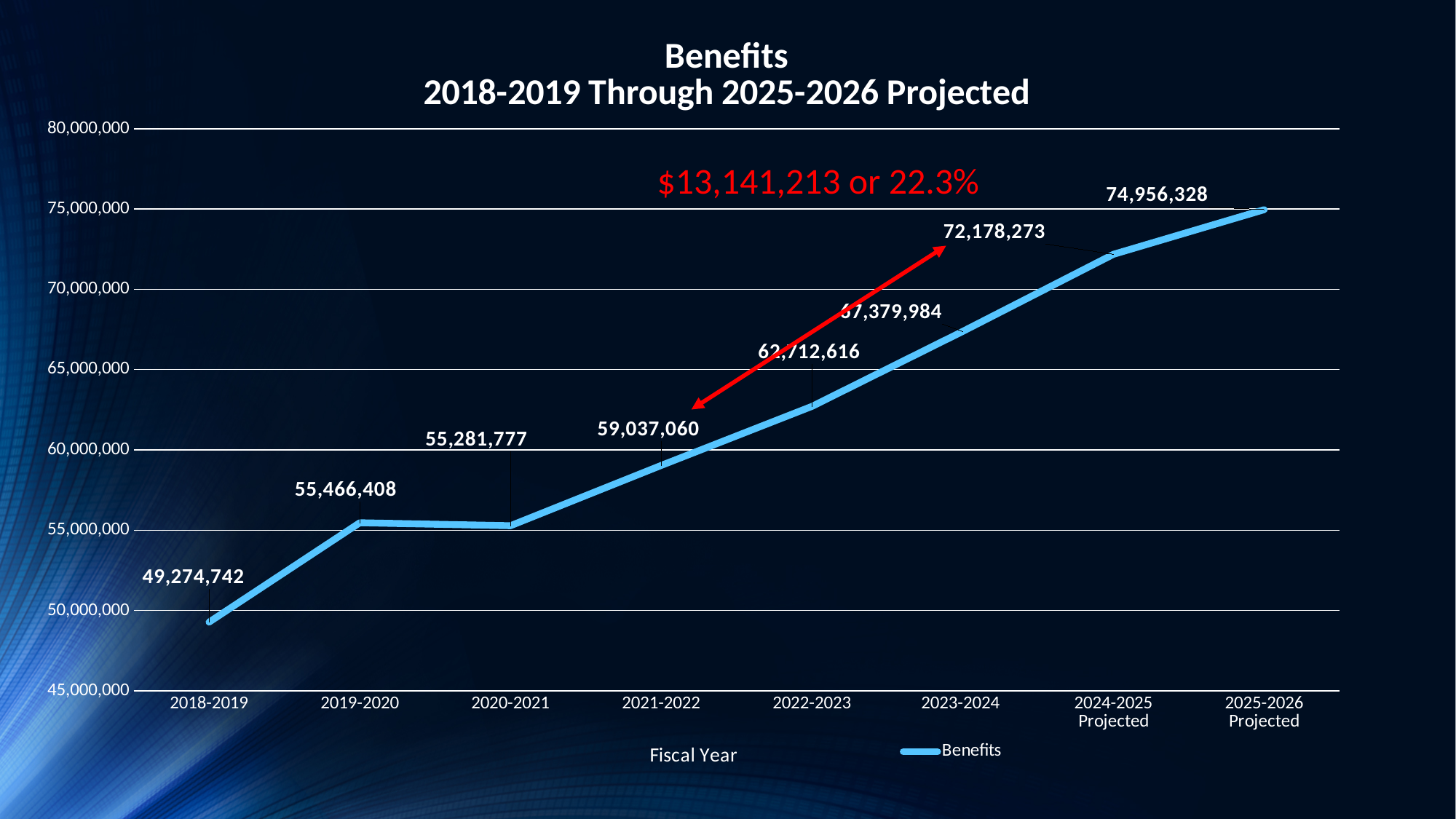
Which fiscal year has the highest Benefits value? 2025-2026 Projected What is the Benefits value for 2019-2020? 55,466,408 What is the difference between the Benefits values for 2025-2026 Projected and 2024-2025 Projected? 2,778,055 Is the Benefits value for 2022-2023 greater or less than 60,000,000? greater How many fiscal years are plotted on the chart? 8 What is the Benefits value for 2021-2022? 59,037,060 What increase does the red annotation on the chart state? $13,141,213 or 22.3% What is the Benefits value for 2025-2026 Projected? 74,956,328 What is the Benefits value for 2018-2019? 49,274,742 Which fiscal year has the lowest Benefits value? 2018-2019 What type of chart is shown on the slide? Line chart Which is larger, the Benefits value for 2019-2020 or for 2020-2021? 2019-2020